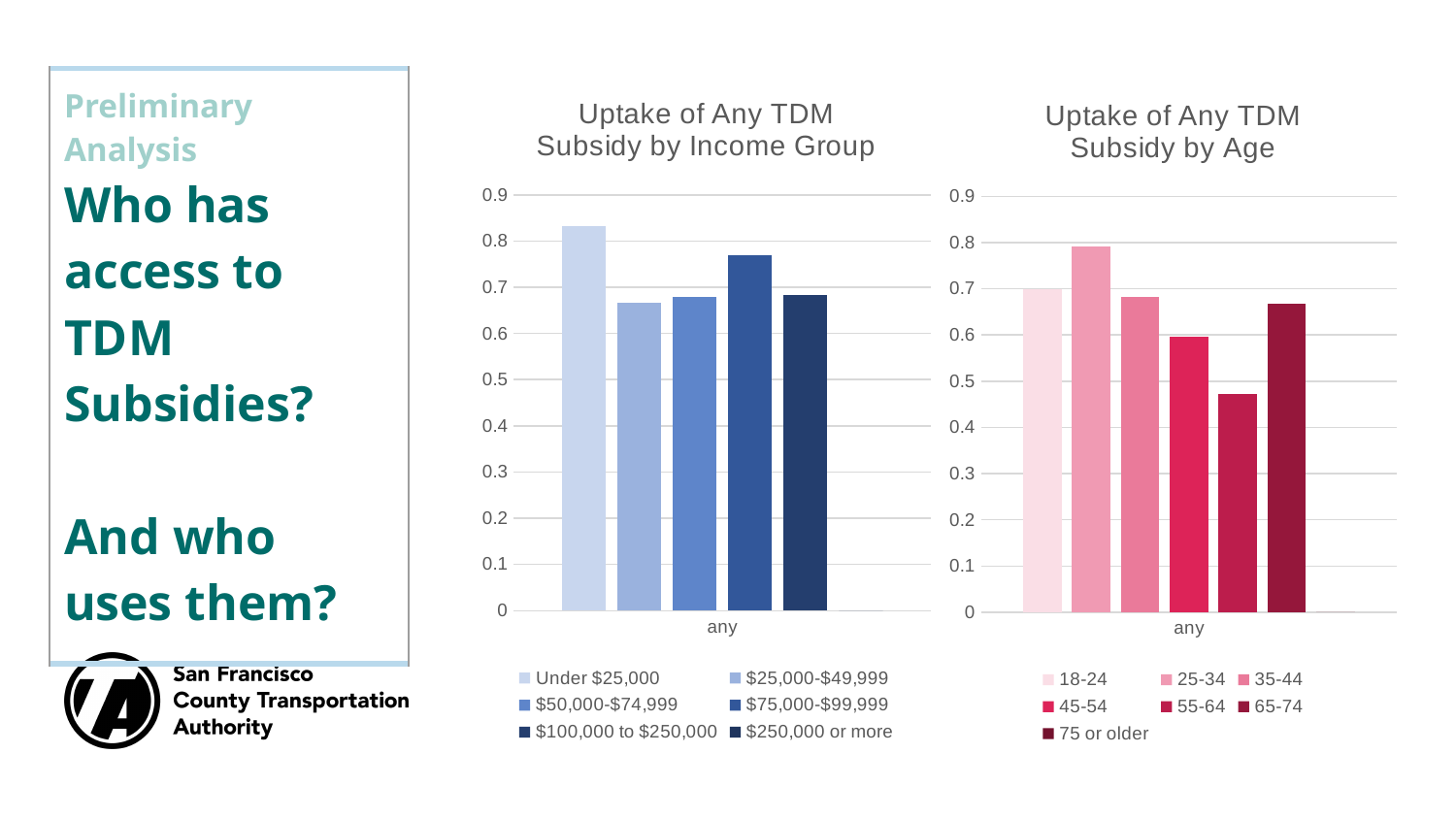
In the "Uptake of Any TDM Subsidy by Income Group" chart, which income group has the highest uptake? Under $25,000 In the "Uptake of Any TDM Subsidy by Income Group" chart, is the value for Under $25,000 greater or less than 0.8? greater In the "Uptake of Any TDM Subsidy by Age" chart, how many bars are plotted? 6 In the "Uptake of Any TDM Subsidy by Age" chart, which age group has the highest uptake? 25-34 In the "Uptake of Any TDM Subsidy by Age" chart, is the value for 55-64 greater or less than 0.5? less In the "Uptake of Any TDM Subsidy by Income Group" chart, how many series does the legend list? 6 In the "Uptake of Any TDM Subsidy by Age" chart, which is larger: the value for 18-24 or for 45-54? 18-24 What kind of chart is "Uptake of Any TDM Subsidy by Income Group"? bar chart In the "Uptake of Any TDM Subsidy by Age" chart, which age group has the lowest uptake? 55-64 In the "Uptake of Any TDM Subsidy by Age" chart, how many series does the legend list? 7 In the "Uptake of Any TDM Subsidy by Age" chart, is the value for 25-34 greater or less than 0.7? greater In the "Uptake of Any TDM Subsidy by Income Group" chart, which is larger: the value for Under $25,000 or for $75,000-$99,999? Under $25,000